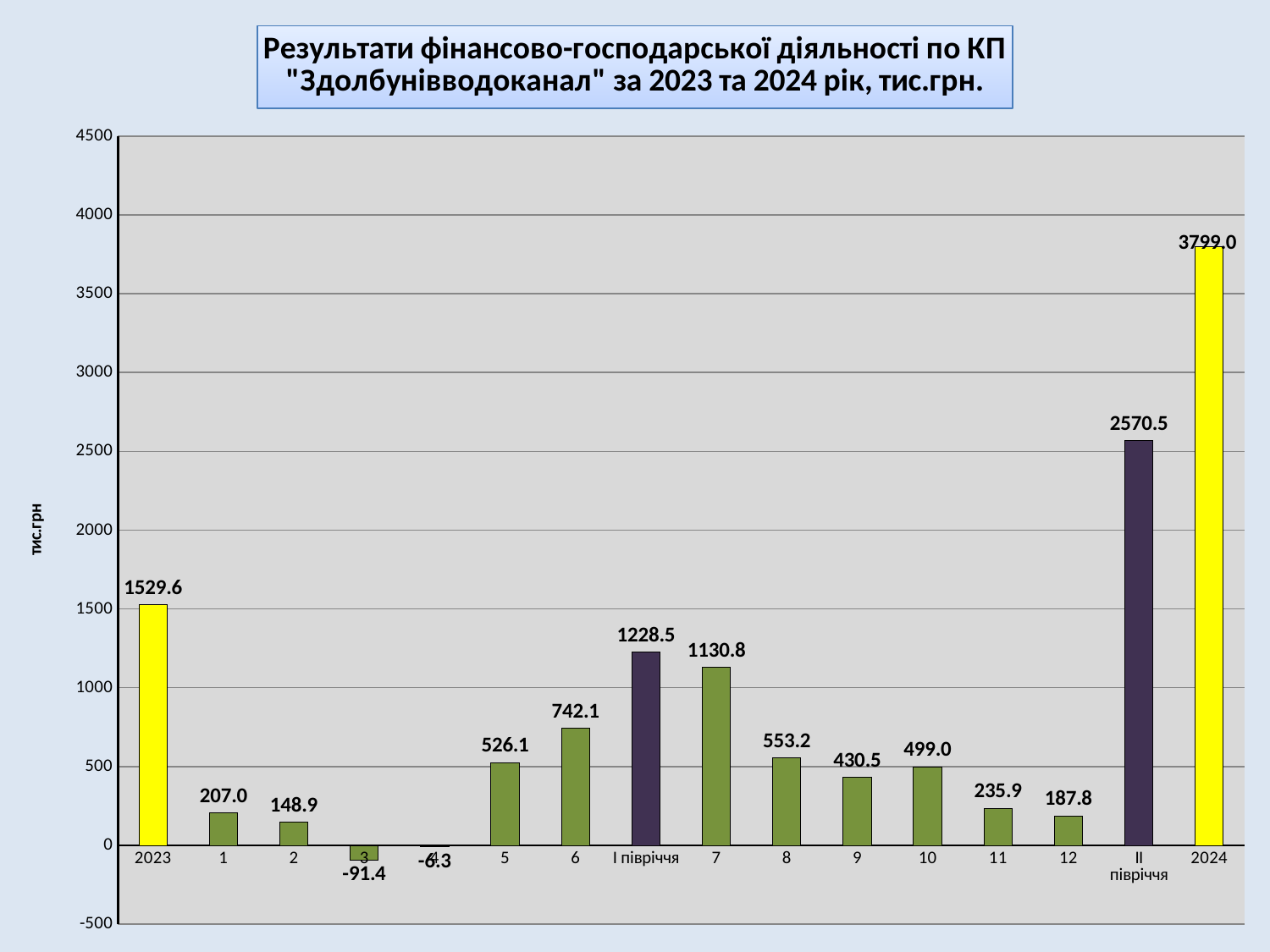
How many bars are plotted on the chart? 16 What is the value for 2023? 1529.6 What is the value for month 3? -91.4 What is the label of the vertical axis? тис.грн What is the value for І півріччя? 1228.5 What kind of chart is shown on the slide? bar chart What is the difference between the values for 2024 and 2023? 2269.4 Which is larger, the value for month 7 or the value for month 8? 7 Which category has the highest value? 2024 What is the value for 2024? 3799.0 Which category has the lowest value? 3 Is the value for ІІ півріччя greater or less than 2500? greater